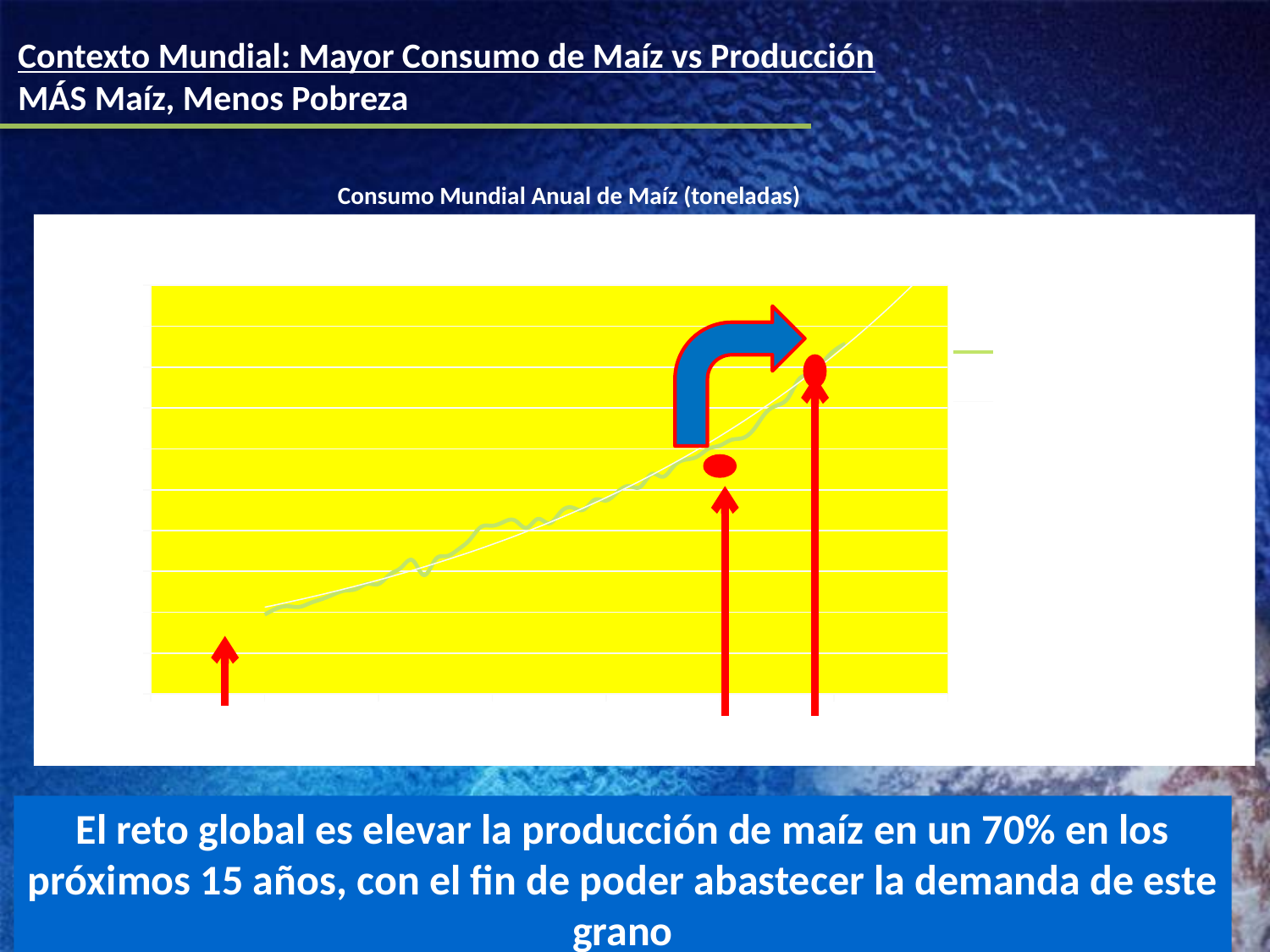
What colour is the plot area background of the chart? yellow What is the title of the chart? Consumo Mundial Anual de Maíz (toneladas) What kind of chart is shown on the slide? line chart Does the plotted line rise or fall from left to right along the x axis? rise